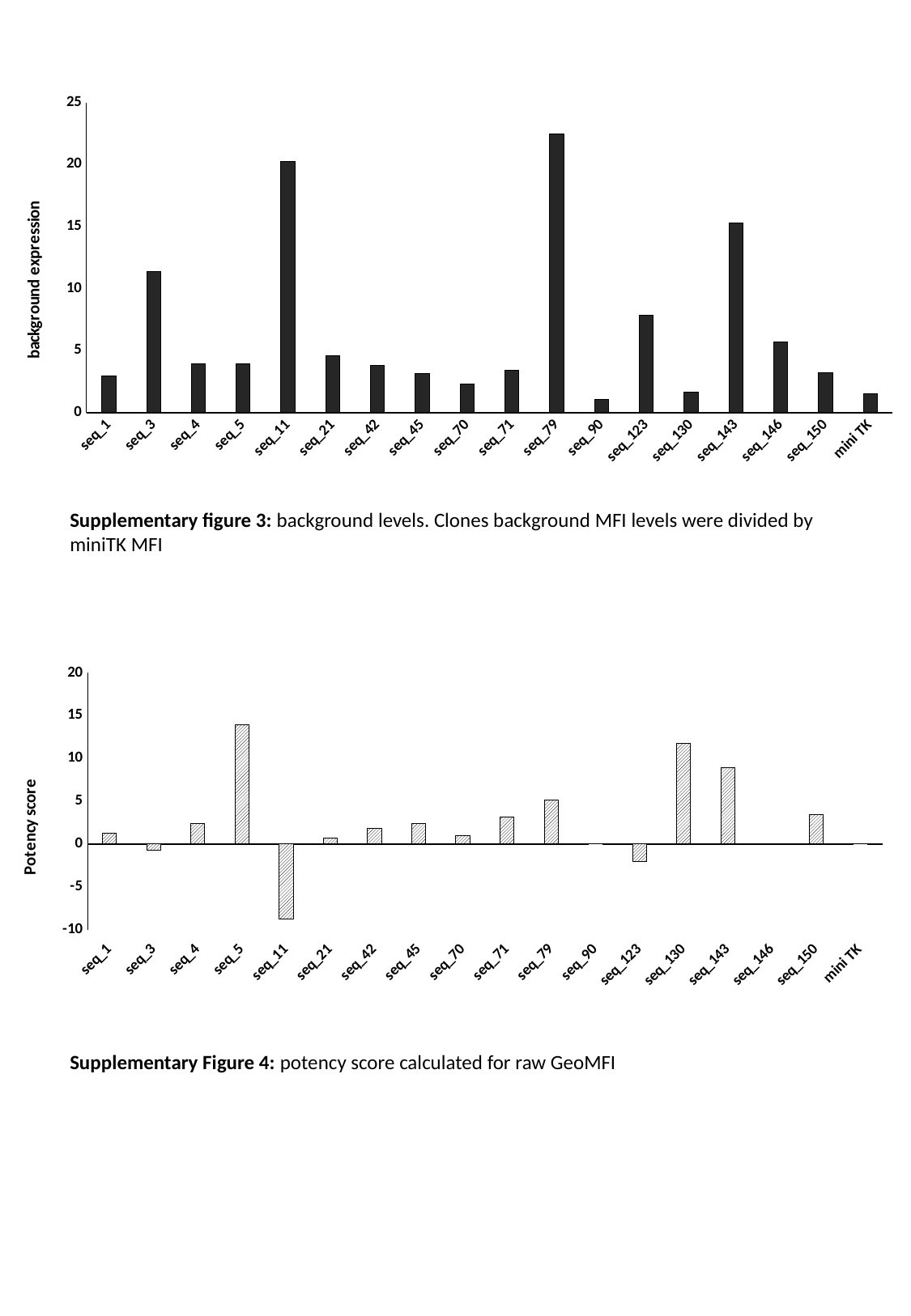
How many categories are shown on the x axis of the top chart (background expression)? 18 In the bottom chart (Potency score), is the value for seq_11 greater or less than -5? less In the bottom chart (Potency score), which category has the highest value? seq_5 In the top chart (background expression), is the value for seq_123 greater or less than 10? less What is the y-axis label of the top chart? background expression What kind of chart is the bottom chart (Potency score)? bar chart In the bottom chart (Potency score), which category has the lowest value? seq_11 In the top chart (background expression), which is larger, the value for seq_143 or the value for seq_146? seq_143 In the top chart (background expression), which category has the highest value? seq_79 In the top chart (background expression), is the value for seq_11 greater or less than 15? greater In the bottom chart (Potency score), which is larger, the value for seq_130 or the value for seq_143? seq_130